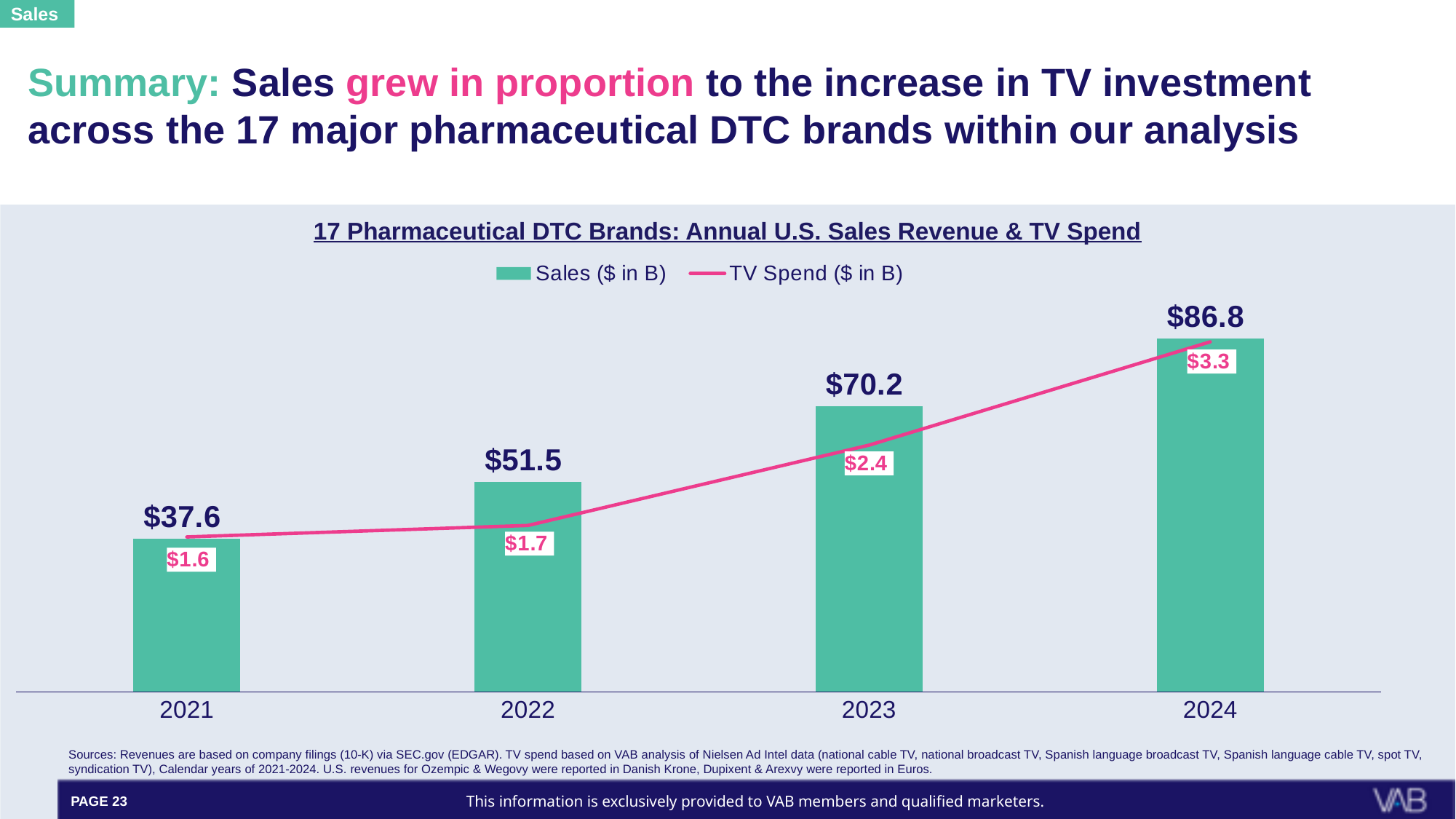
Do Sales ($ in B) rise or fall from 2021 to 2024? rise What is the TV Spend ($ in B) value for 2022? $1.7 Which is larger, Sales in 2022 or Sales in 2023? 2023 What is the Sales ($ in B) value for 2024? $86.8 What is the Sales ($ in B) value for 2021? $37.6 How many years are shown on the x axis? 4 What is the difference in Sales ($ in B) between 2024 and 2023? $16.6 What is the difference in TV Spend ($ in B) between 2024 and 2021? $1.7 How many series does the legend list? 2 Which year has the lowest TV Spend ($ in B)? 2021 Which year has the highest Sales ($ in B)? 2024 What is the TV Spend ($ in B) value for 2023? $2.4